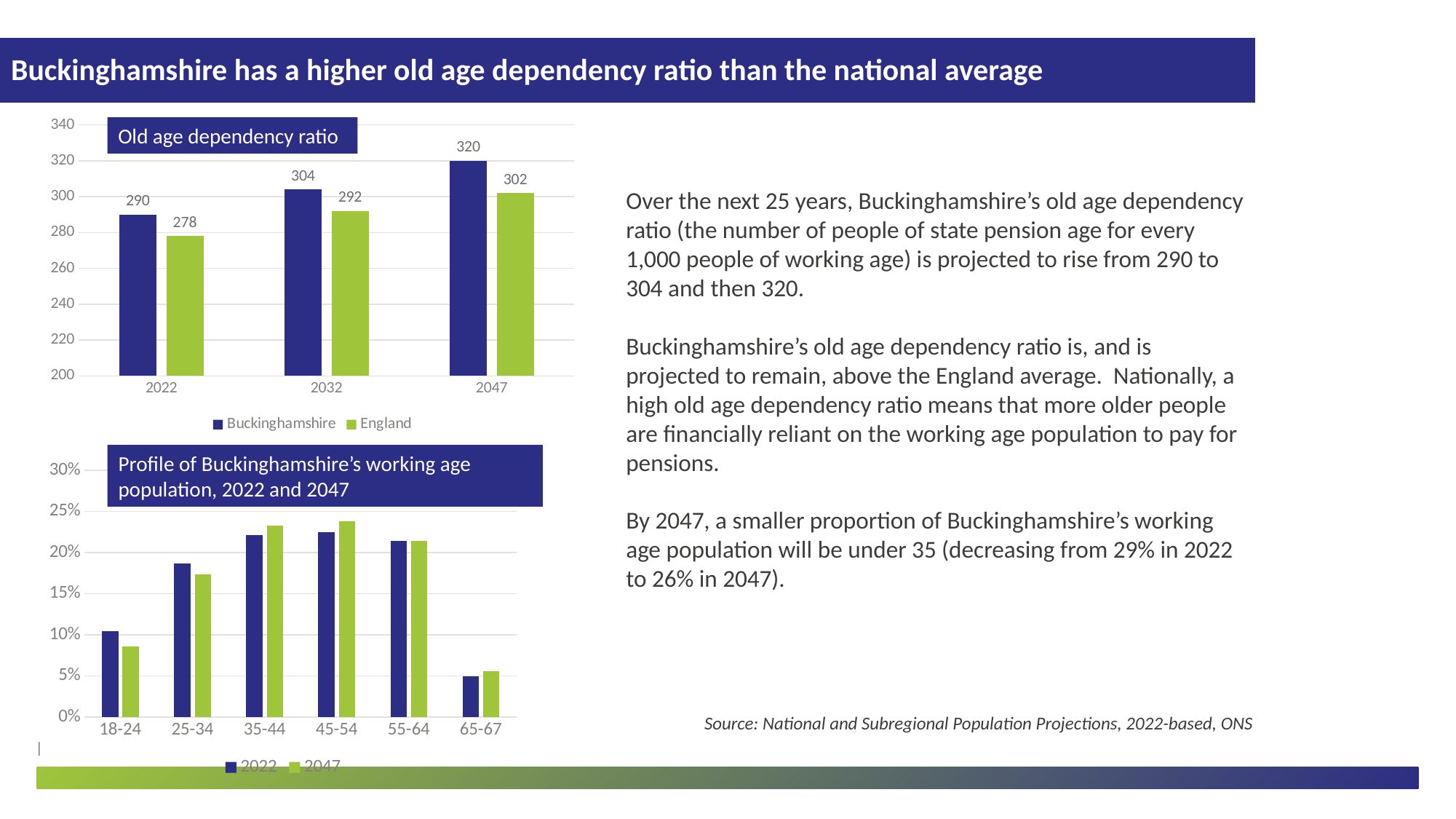
In the 'Old age dependency ratio' chart, what is the value for Buckinghamshire in 2032? 304 In the 'Old age dependency ratio' chart, do the values for England rise or fall from 2022 to 2047? rise In the 'Old age dependency ratio' chart, what is the difference between Buckinghamshire and England in 2047? 18 How many age groups are shown on the x axis of the 'Profile of Buckinghamshire's working age population, 2022 and 2047' chart? 6 In the 'Old age dependency ratio' chart, which year has the highest value for Buckinghamshire? 2047 What kind of chart is the 'Profile of Buckinghamshire's working age population, 2022 and 2047' chart? bar chart How many series does the legend of the 'Old age dependency ratio' chart list? 2 In the 'Profile of Buckinghamshire's working age population, 2022 and 2047' chart, which is larger for 25-34: 2022 or 2047? 2022 In the 'Old age dependency ratio' chart, what is the value for England in 2022? 278 In the 'Old age dependency ratio' chart, which is larger in 2032: Buckinghamshire or England? Buckinghamshire In the 'Profile of Buckinghamshire's working age population, 2022 and 2047' chart, which age group has the lowest value for 2022? 65-67